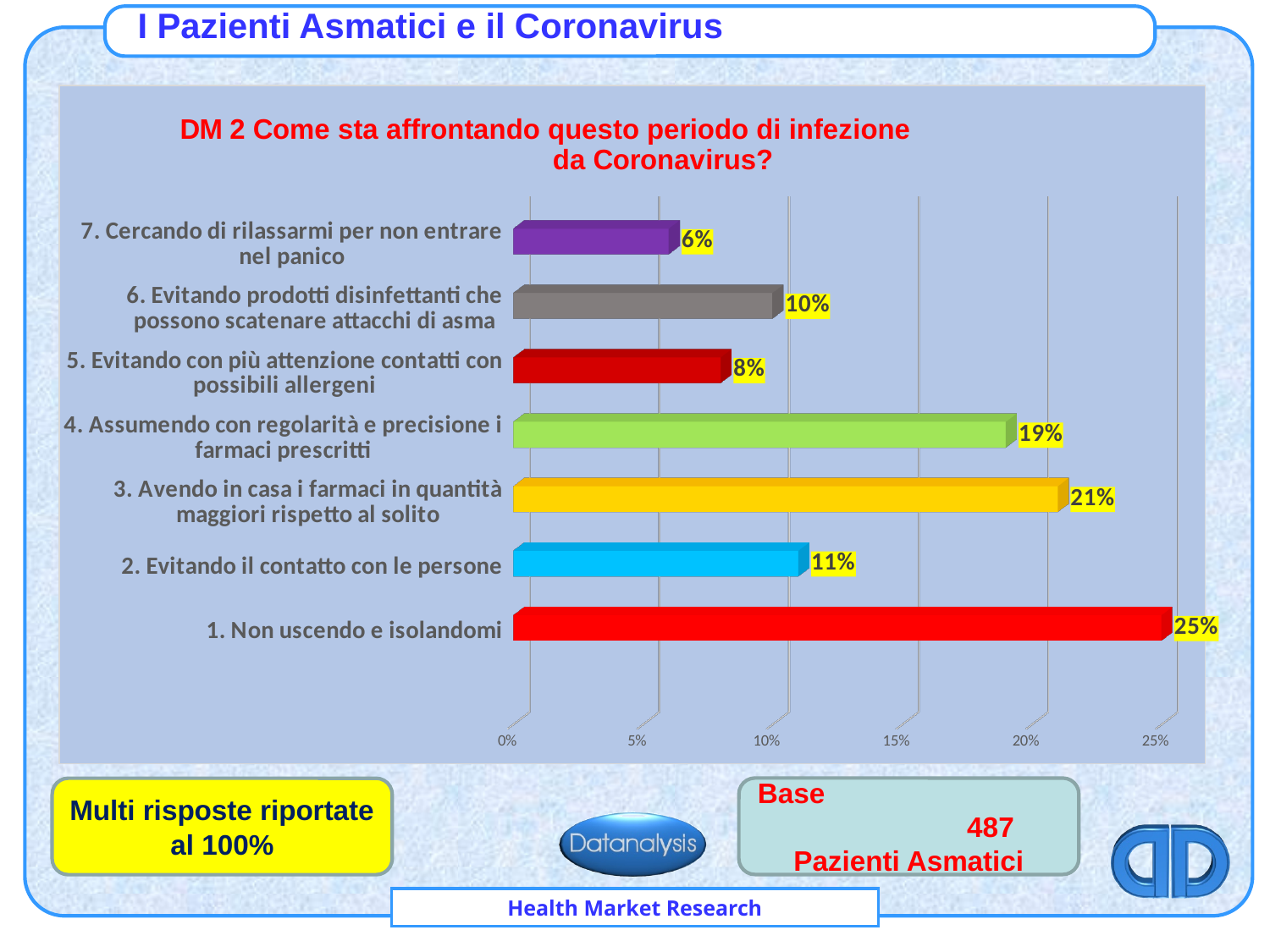
What kind of chart is shown on the slide? bar chart What is the value for "2. Evitando il contatto con le persone"? 11% What is the difference between the values for "3. Avendo in casa i farmaci in quantità maggiori rispetto al solito" and "5. Evitando con più attenzione contatti con possibili allergeni"? 13% What is the value for "4. Assumendo con regolarità e precisione i farmaci prescritti"? 19% Is the value for "4. Assumendo con regolarità e precisione i farmaci prescritti" greater or less than 15%? greater What is the value for "1. Non uscendo e isolandomi"? 25% What is the title of the chart? DM 2 Come sta affrontando questo periodo di infezione da Coronavirus? Which is larger, the value for "2. Evitando il contatto con le persone" or for "6. Evitando prodotti disinfettanti che possono scatenare attacchi di asma"? 2. Evitando il contatto con le persone What is the value for "6. Evitando prodotti disinfettanti che possono scatenare attacchi di asma"? 10% Which category has the lowest value? 7. Cercando di rilassarmi per non entrare nel panico Which category has the highest value? 1. Non uscendo e isolandomi How many categories are shown in the chart? 7